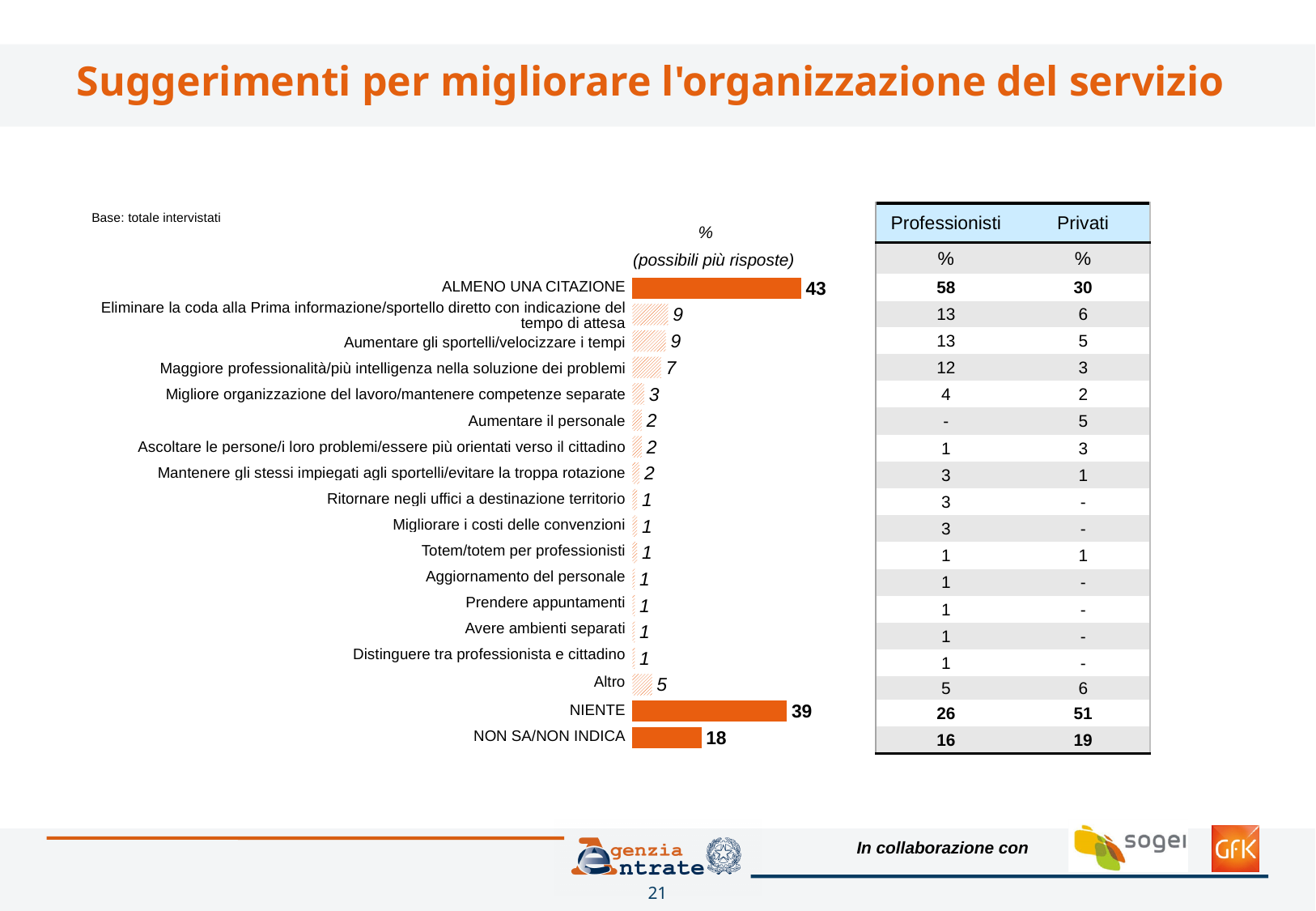
What is the value for Maggiore professionalità/più intelligenza nella soluzione dei problemi? 7 What is the difference between the values for NIENTE and NON SA/NON INDICA? 21 What is the value for NIENTE? 39 What is the value for Altro? 5 What is the value for NON SA/NON INDICA? 18 Which is larger, the value for Altro or the value for Migliore organizzazione del lavoro/mantenere competenze separate? Altro What is the value for ALMENO UNA CITAZIONE? 43 How many categories are shown in the bar chart? 18 What is the value for Aumentare gli sportelli/velocizzare i tempi? 9 What kind of chart is shown on the slide? Bar chart What is the difference between the values for ALMENO UNA CITAZIONE and NIENTE? 4 Which category has the highest value in the chart? ALMENO UNA CITAZIONE